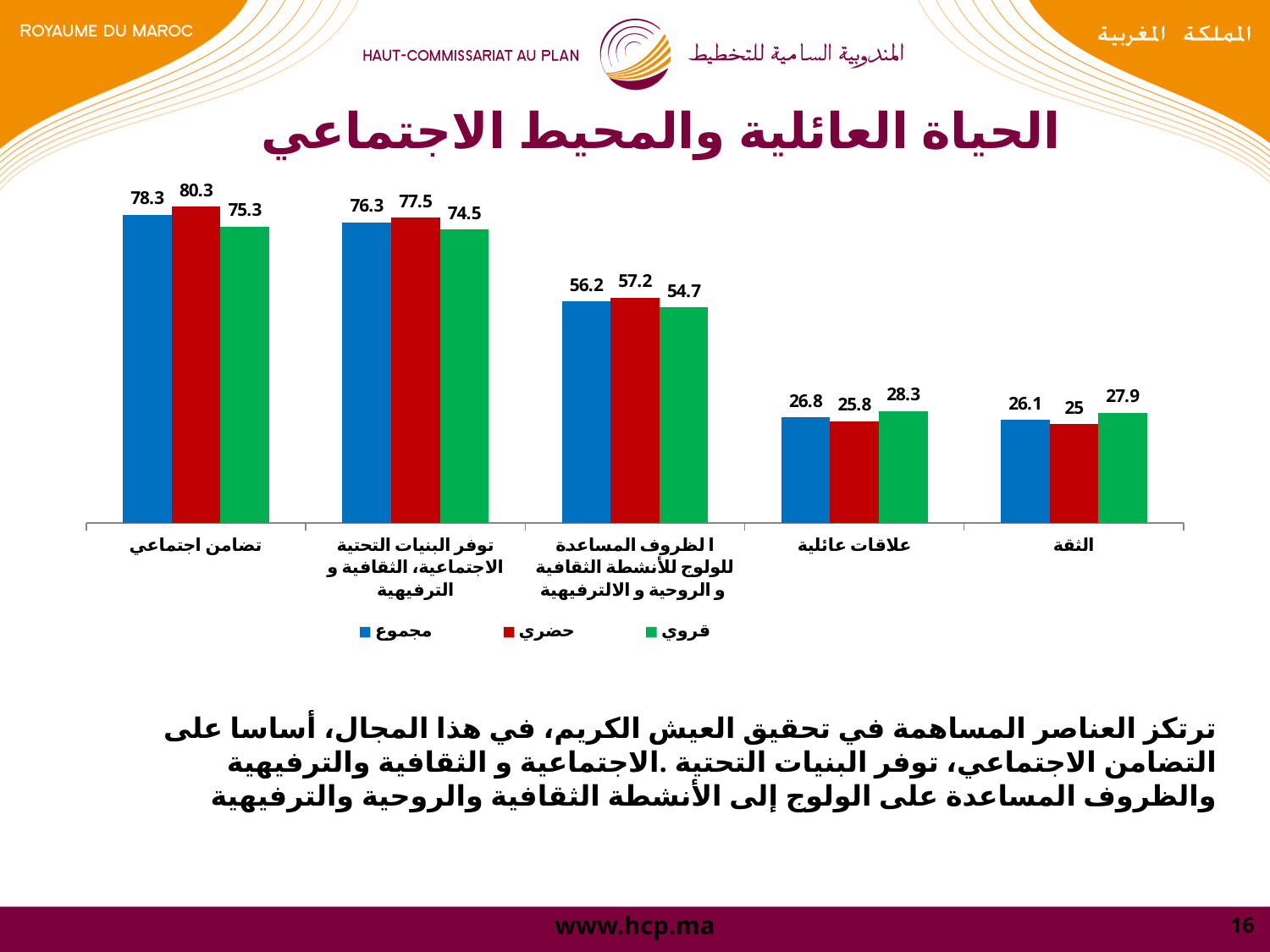
Which category has the highest value for the مجموع series? تضامن اجتماعي How many categories are shown on the x axis of the chart? 5 What kind of chart is shown on the slide? bar chart What is the value for حضري in the تضامن اجتماعي category? 80.3 What is the value for مجموع in the علاقات عائلية category? 26.8 How many series does the chart legend list? 3 What is the value for قروي in the الثقة category? 27.9 Which category has the lowest value for the حضري series? الثقة Which is larger in the علاقات عائلية category: the حضري value or the قروي value? قروي Which series is shown in red in the chart legend? حضري What is the difference between the حضري and قروي values in the تضامن اجتماعي category? 5 Do the مجموع values rise or fall moving from تضامن اجتماعي on the left to الثقة on the right? fall